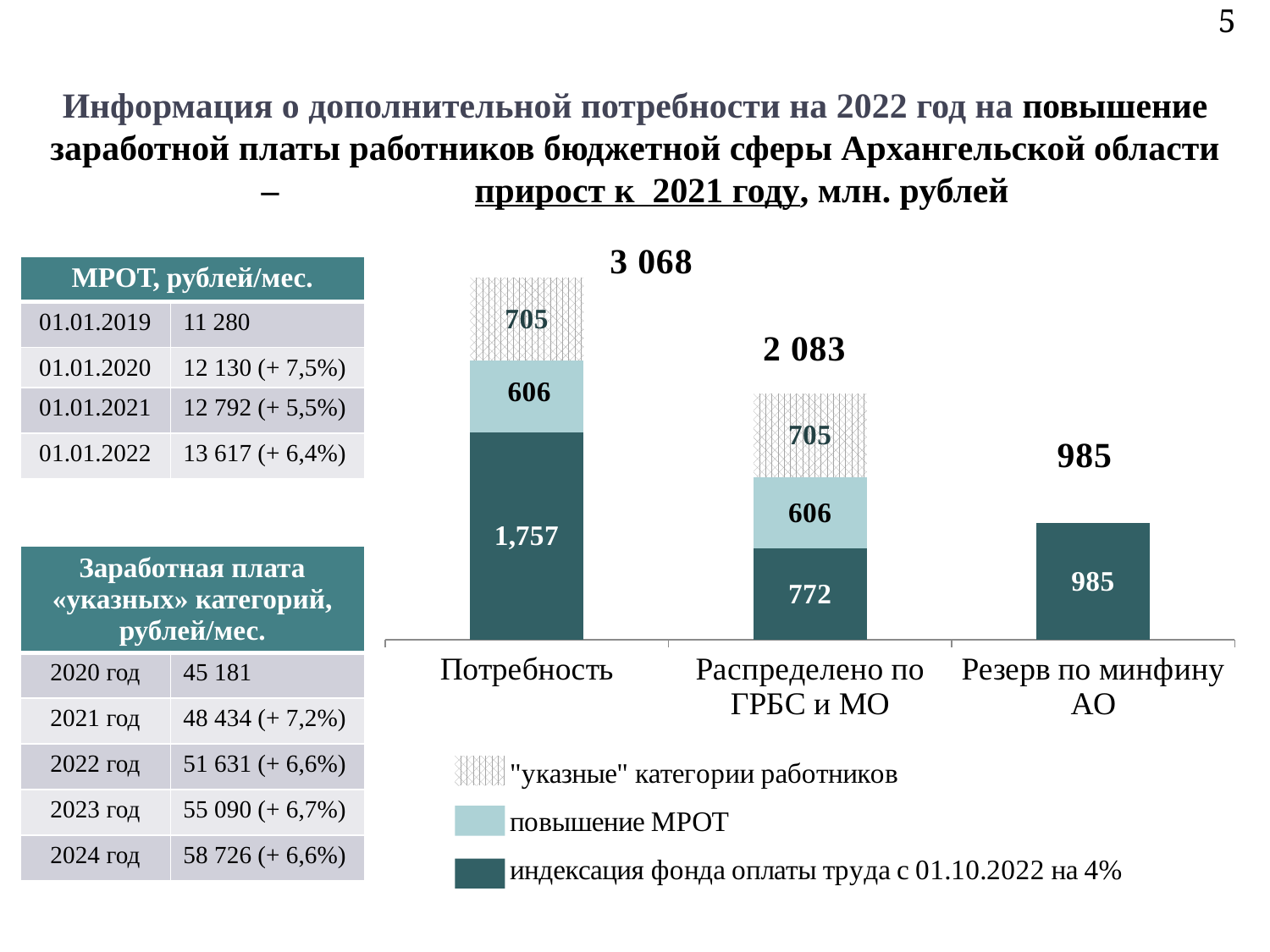
What is the value of the "указные" категории работников segment for "Потребность"? 705 How many categories are shown on the x axis of the chart? 3 What is the difference between the "индексация фонда оплаты труда" segment for "Потребность" and for "Распределено по ГРБС и МО"? 985 What is the value of the "индексация фонда оплаты труда с 01.10.2022 на 4%" segment for "Потребность"? 1,757 What is the total value of the "Распределено по ГРБС и МО" bar? 2 083 How many series does the chart legend list? 3 What type of chart is shown on the slide? stacked bar chart Which category has the lowest total value? Резерв по минфину АО Which category has the highest total value? Потребность What is the total value of the "Потребность" bar? 3 068 What is the value shown for "Резерв по минфину АО"? 985 What is the value of the "повышение МРОТ" segment for "Распределено по ГРБС и МО"? 606